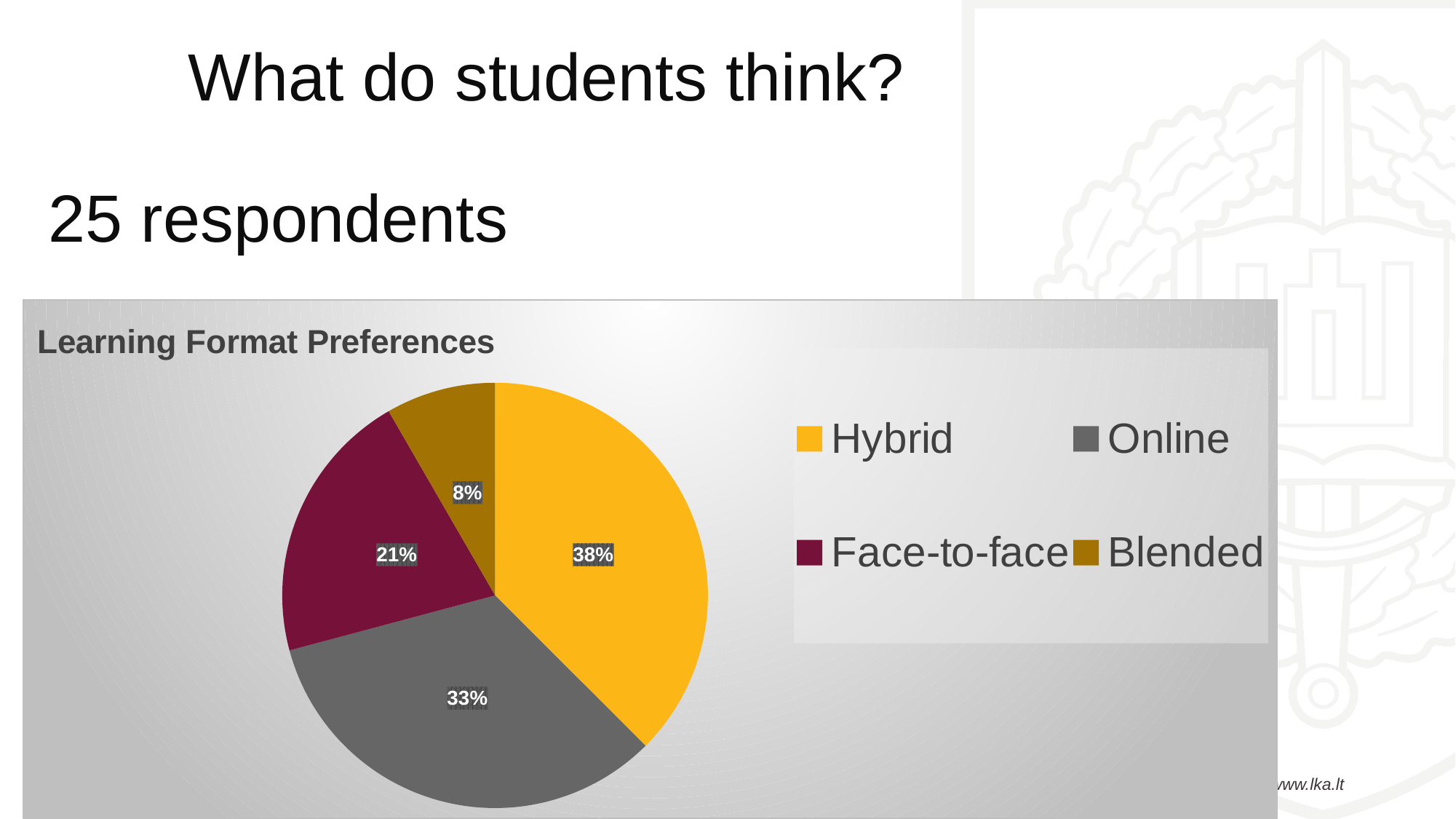
How many categories does the pie chart have? 4 What is the title of the chart? Learning Format Preferences Which learning format has the smallest share? Blended Which learning format has the largest share? Hybrid What type of chart is shown on the slide? pie chart Which has a larger share, Online or Face-to-face? Online What share of the pie does Hybrid represent? 38% What share of the pie does Face-to-face represent? 21% What share of the pie does Blended represent? 8% What is the difference in percentage points between Hybrid and Online? 5 What is the difference in percentage points between Face-to-face and Blended? 13